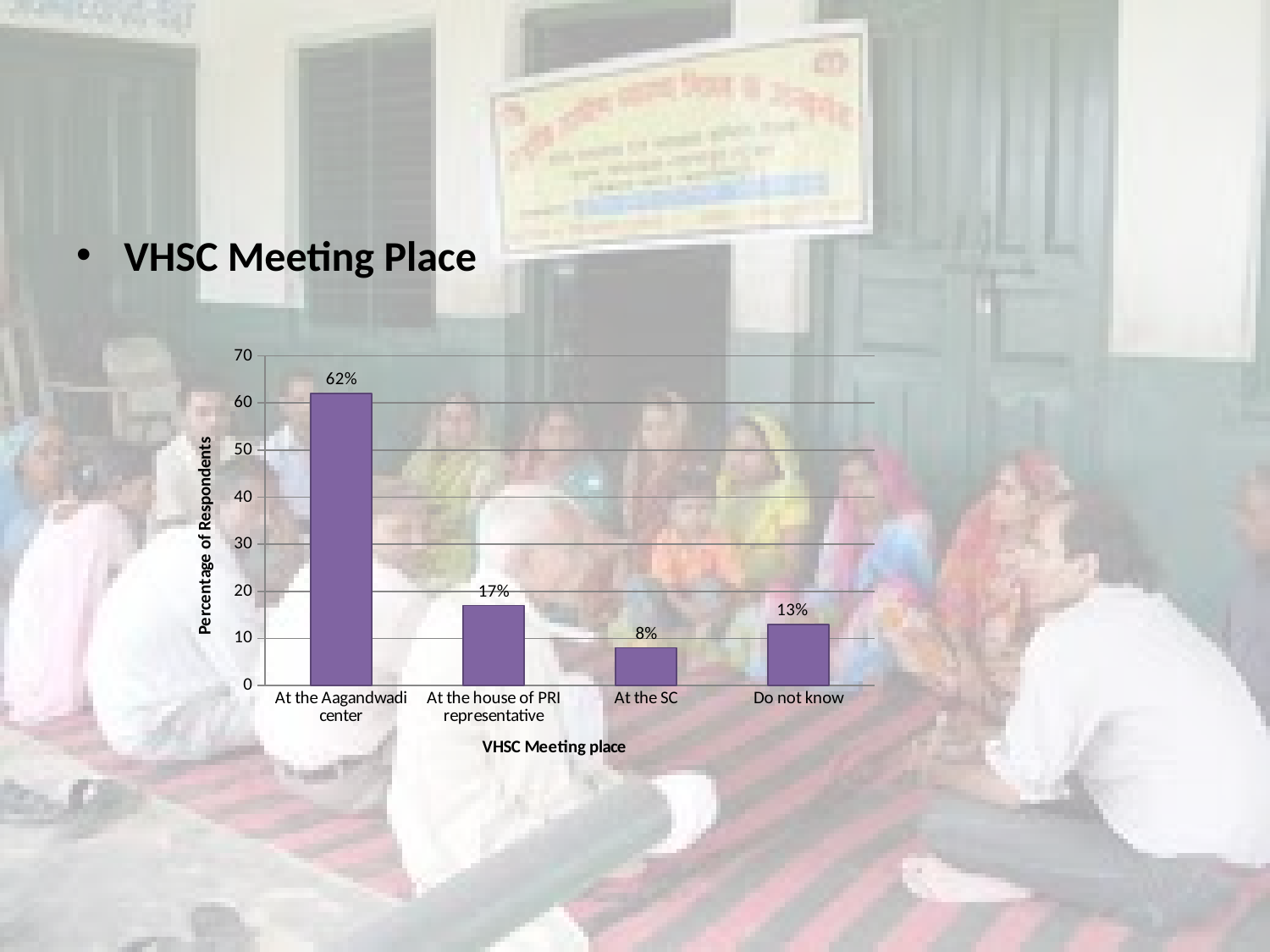
Which VHSC meeting place has the lowest percentage of respondents? At the SC Which is larger: the percentage for 'Do not know' or for 'At the SC'? Do not know What is the difference in percentage points between 'At the Aagandwadi center' and 'At the house of PRI representative'? 45 What percentage of respondents said the VHSC meeting takes place at the house of PRI representative? 17% Is the value for 'At the Aagandwadi center' greater or less than 60? greater What type of chart is shown on the slide? Bar chart What percentage of respondents answered 'Do not know' about the VHSC meeting place? 13% What percentage of respondents said the VHSC meeting takes place at the Aagandwadi center? 62% Which VHSC meeting place has the highest percentage of respondents? At the Aagandwadi center What is the label of the y axis of the chart? Percentage of Respondents What percentage of respondents said the VHSC meeting takes place at the SC? 8% How many meeting place categories are shown on the x axis? 4